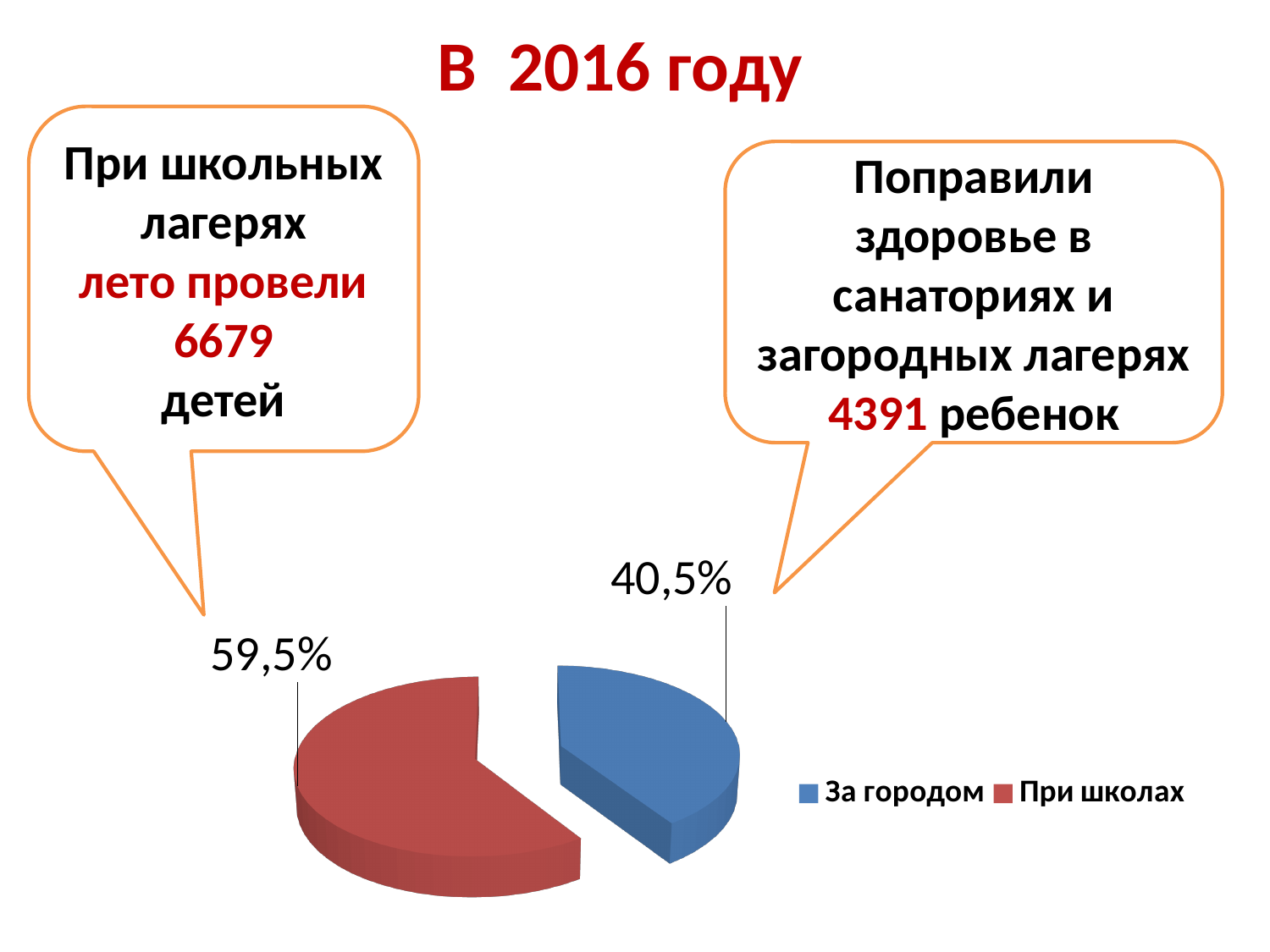
How many entries does the legend list? 2 What is the title shown above the chart on the slide? В 2016 году What is the difference in percentage points between the "При школах" and "За городом" slices? 19 percentage points Is the share of the "За городом" slice greater or less than 50%? less How many slices does the pie chart have? 2 What share of the pie does the "При школах" slice represent? 59,5% Which slice of the pie is the largest? При школах What colour is the "За городом" slice in the pie chart? blue What kind of chart is shown on the slide? pie chart What share of the pie does the "За городом" slice represent? 40,5% Which is larger: the "За городом" slice or the "При школах" slice? При школах Which slice of the pie is the smallest? За городом